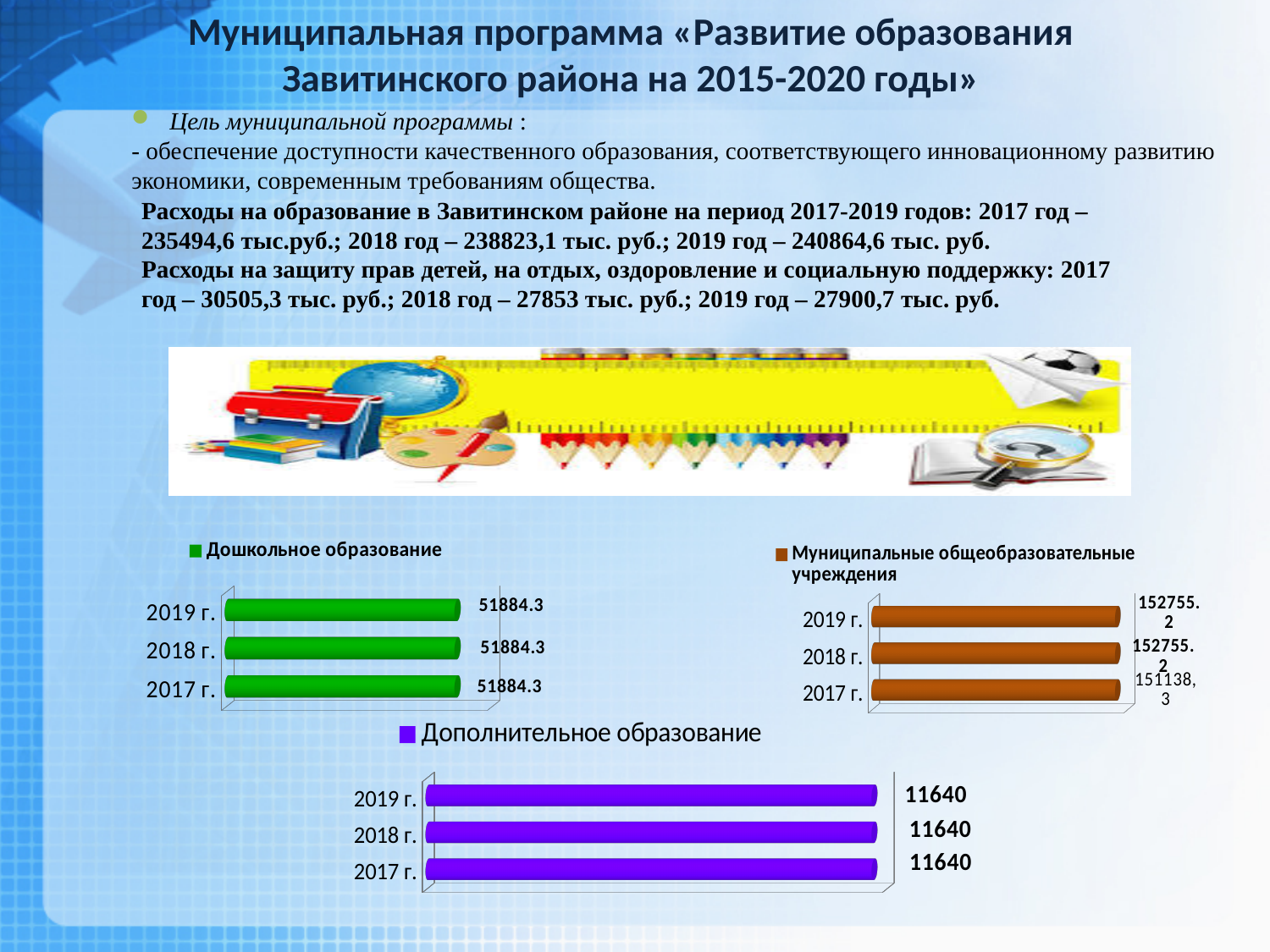
In the 'Муниципальные общеобразовательные учреждения' chart, what is the value for 2019 г.? 152755.2 In the 'Дополнительное образование' chart, what is the value for 2018 г.? 11640 What kind of chart is the 'Дошкольное образование' chart? Bar chart In the 'Дошкольное образование' chart, what is the value for 2019 г.? 51884.3 What colour are the bars in the 'Дополнительное образование' chart? Purple In the 'Муниципальные общеобразовательные учреждения' chart, what is the value for 2017 г.? 151138,3 In the 'Дошкольное образование' chart, what is the value for 2017 г.? 51884.3 How many years are shown in the 'Дополнительное образование' chart? 3 In the 'Дополнительное образование' chart, do the values change from 2017 г. to 2019 г.? No, they stay the same